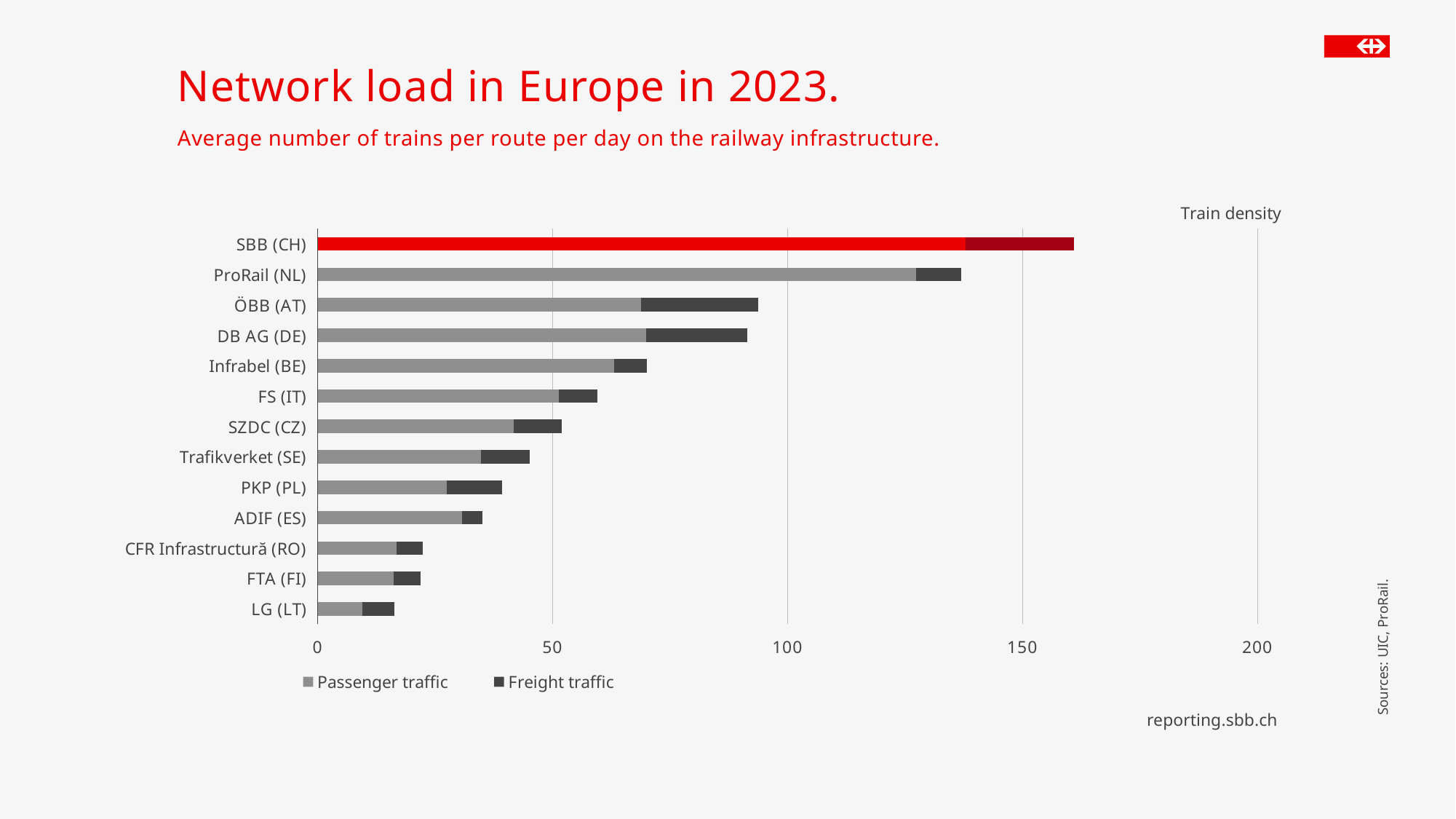
Is the total train density for ÖBB (AT) greater or less than 100? less Is the total train density for ProRail (NL) greater or less than 150? less What kind of chart is shown on the slide? bar chart How many series does the legend list? 2 Is the passenger traffic value for SBB (CH) greater or less than 100? greater Which operator has the highest total train density? SBB (CH) Which series is shown in the darker colour in the legend? Freight traffic Which has a larger total train density, ProRail (NL) or ÖBB (AT)? ProRail (NL) Which operator has the lowest total train density? LG (LT) How many railway infrastructure operators are listed on the chart? 13